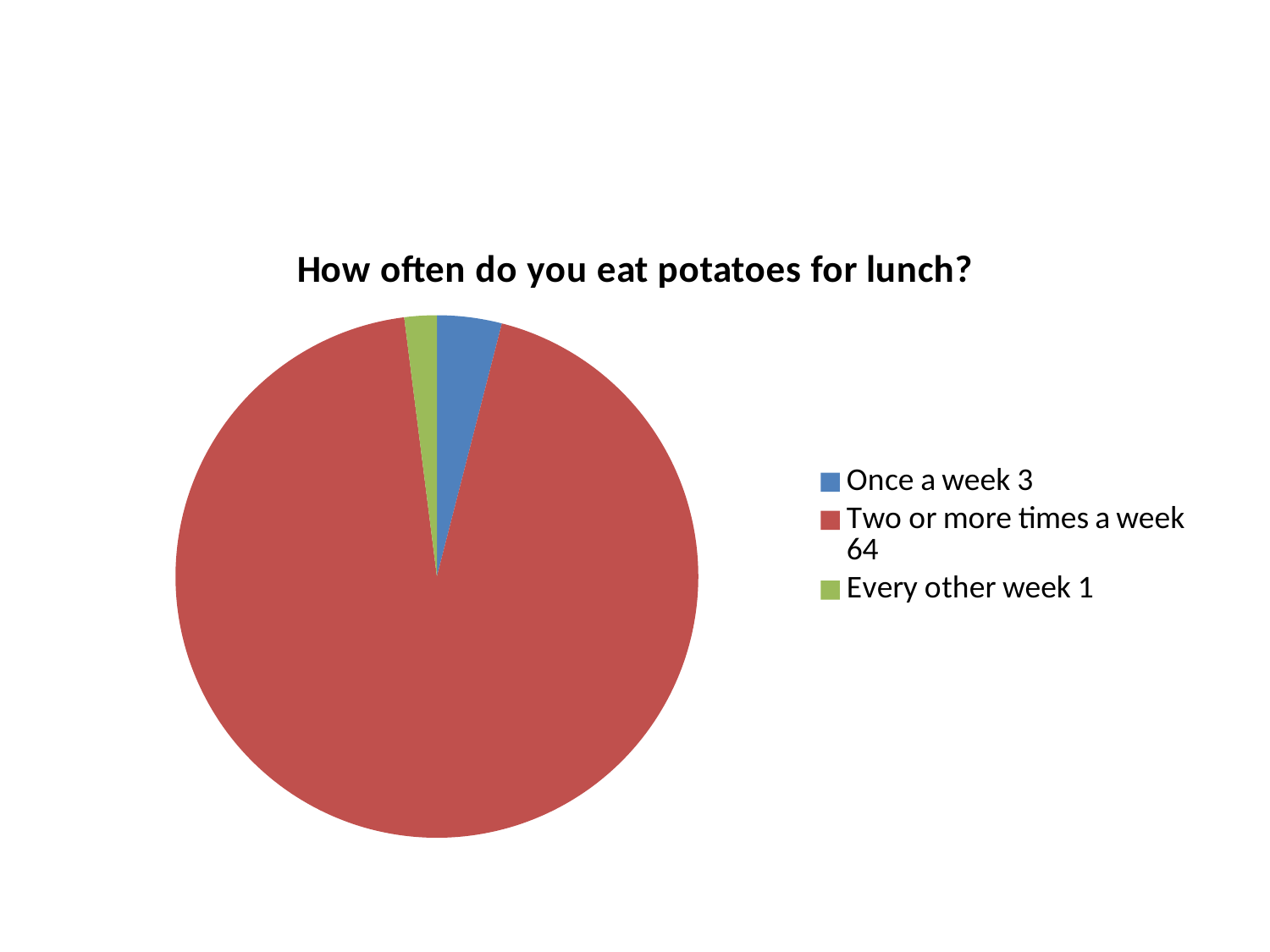
What type of chart is shown on the slide? Pie chart What is the value for "Once a week"? 3 Which is larger, the value for "Once a week" or the value for "Every other week"? Once a week Which category has the largest slice of the pie? Two or more times a week What is the value for "Two or more times a week"? 64 What colour is the slice for "Every other week"? Green What is the title of the chart? How often do you eat potatoes for lunch? What is the value for "Every other week"? 1 What is the difference between the values for "Two or more times a week" and "Once a week"? 61 Which category has the smallest slice of the pie? Every other week What is the total of all the values in the pie chart? 68 How many categories does the pie chart have? 3